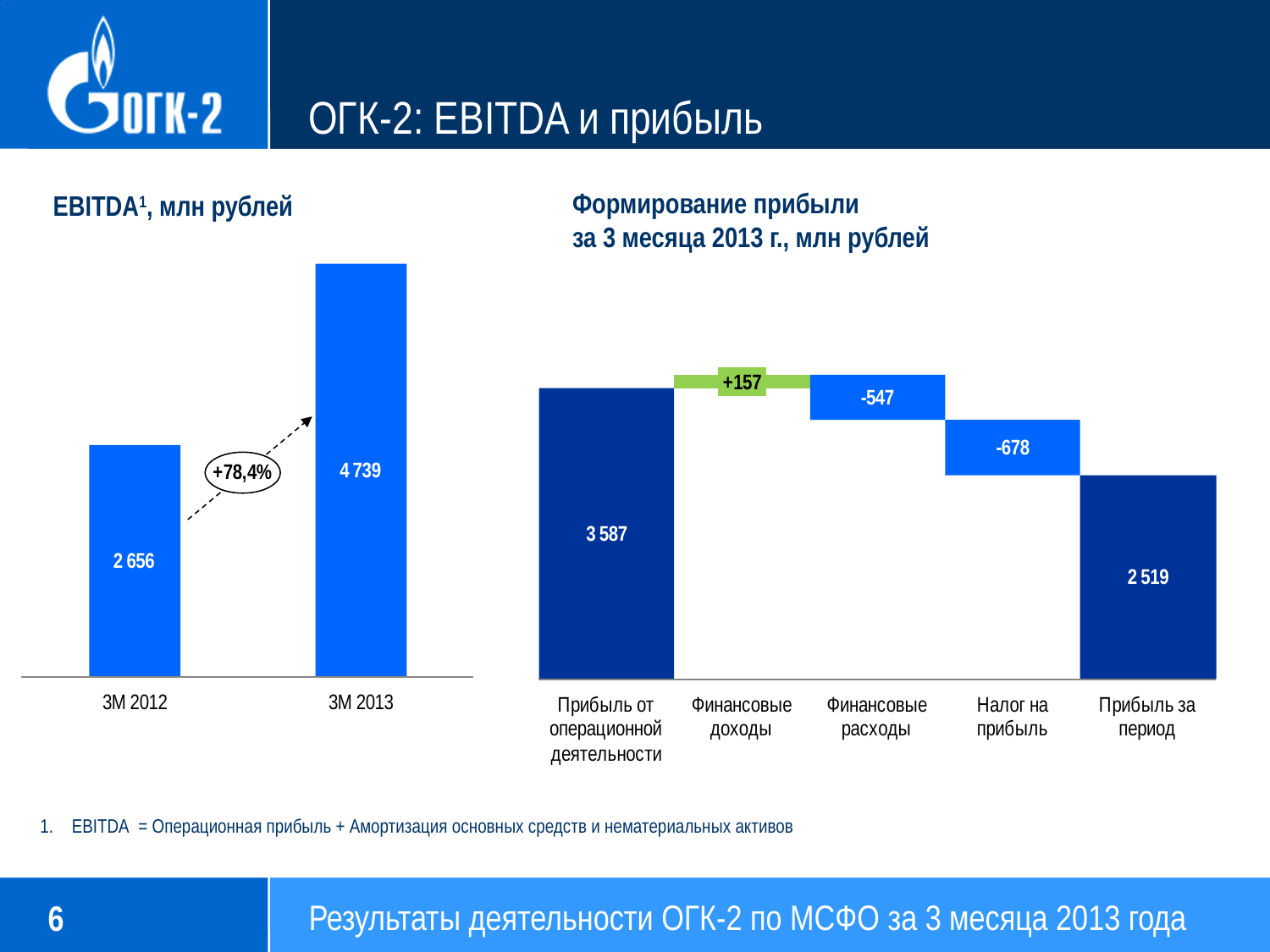
On the EBITDA chart, how many bars are plotted? 2 On the EBITDA chart, what is the EBITDA value for 3M 2012? 2 656 On the 'Формирование прибыли' chart, what is the value for 'Прибыль за период'? 2 519 On the EBITDA chart, what is the difference between the 3M 2013 and 3M 2012 values? 2 083 On the 'Формирование прибыли' chart, how many categories are shown on the x axis? 5 On the 'Формирование прибыли' chart, what is the value for 'Налог на прибыль'? -678 On the EBITDA chart, what percentage change is shown between 3M 2012 and 3M 2013? +78,4% On the EBITDA chart, what is the EBITDA value for 3M 2013? 4 739 On the EBITDA chart, what kind of chart is it? Bar chart On the 'Формирование прибыли' chart, what is the value for 'Прибыль от операционной деятельности'? 3 587 On the EBITDA chart, which period has the higher EBITDA, 3M 2012 or 3M 2013? 3M 2013 On the 'Формирование прибыли' chart, what is the value for 'Финансовые доходы'? +157